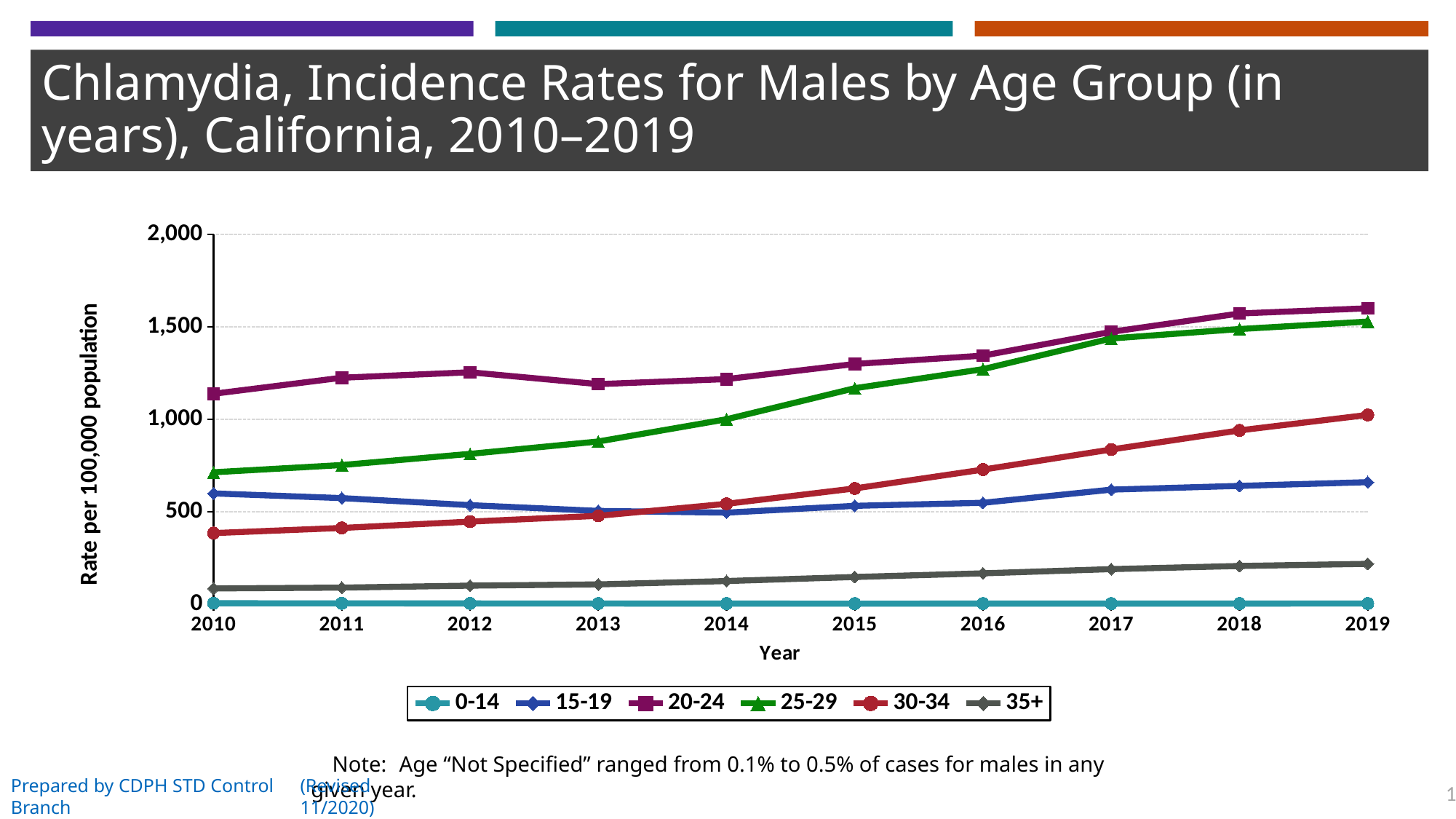
Is the value for the 20-24 age group in 2019 greater or less than 1,500? greater How many years are plotted along the x axis? 10 What is the label of the y axis? Rate per 100,000 population Is the value for the 35+ age group in 2019 greater or less than 500? less Which age group has the lowest incidence rate across all years? 0-14 In 2010, which age group has the larger incidence rate, 15-19 or 30-34? 15-19 What kind of chart is shown on the slide? line chart In 2019, which age group has the larger incidence rate, 25-29 or 30-34? 25-29 Is the value for the 30-34 age group in 2010 greater or less than 500? less Which age group has the highest incidence rate in 2019? 20-24 How many age groups does the legend list? 6 Does the incidence rate for the 25-29 age group rise or fall from 2010 to 2019? rise